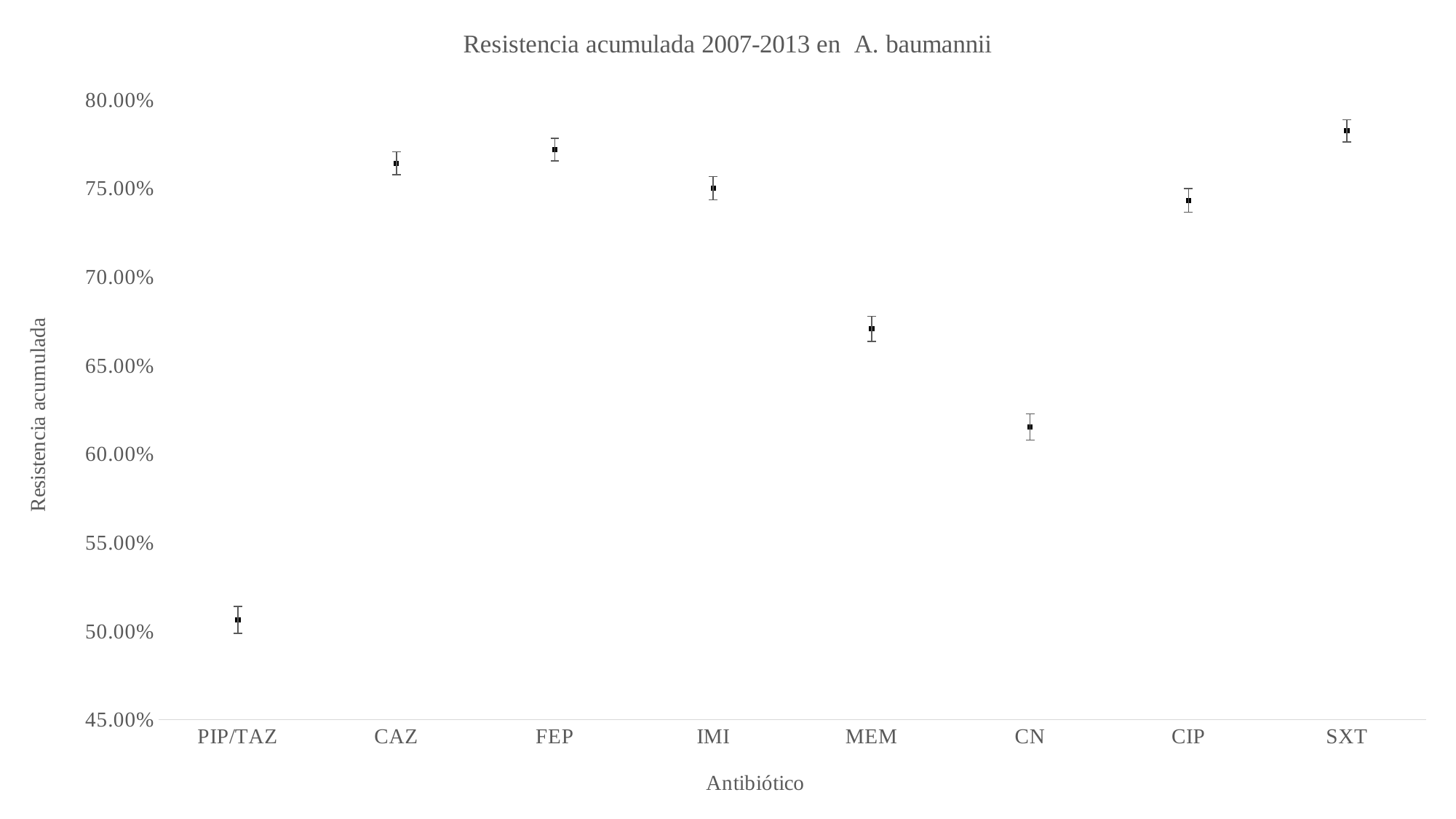
Is the value for SXT greater or less than 80.00%? less Is the value for MEM greater or less than 65.00%? greater Is the value for CAZ greater or less than 75.00%? greater Which has a higher accumulated resistance, MEM or CN? MEM What type of chart is shown on the slide? Scatter (point) chart with error bars Which antibiotic has the highest accumulated resistance? SXT Which has a higher accumulated resistance, CAZ or CIP? CAZ What is the title of the chart? Resistencia acumulada 2007-2013 en A. baumannii Which antibiotic has the lowest accumulated resistance? PIP/TAZ How many antibiotics are plotted on the x axis? 8 What is the label of the x axis? Antibiótico